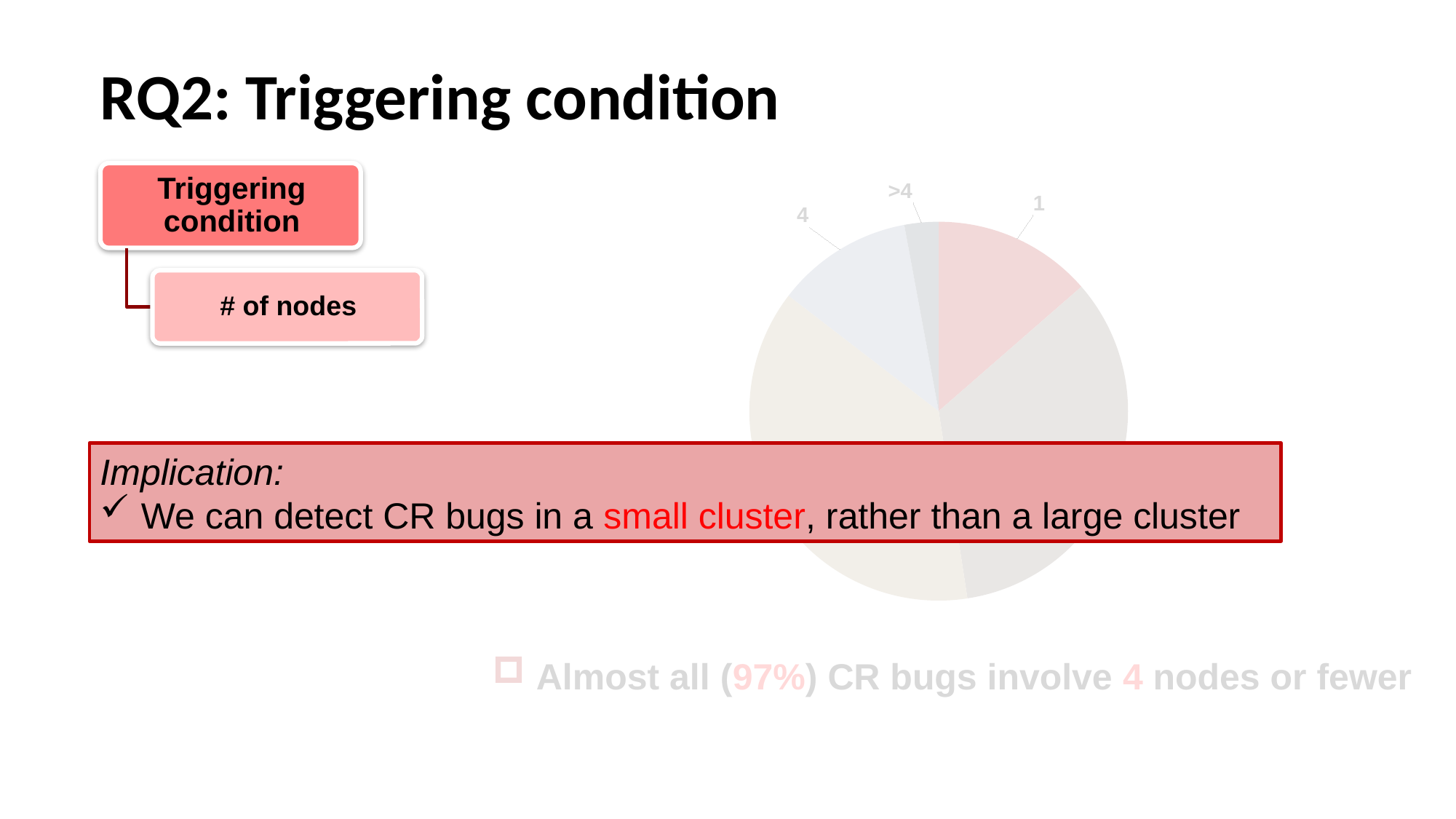
What kind of chart is shown on the slide? pie chart Which slice label in the pie chart indicates more than four nodes? >4 In the pie chart, which slice is larger: the one labelled "4" or the one labelled ">4"? 4 How many slices does the pie chart have? 5 Which labelled slice of the pie chart is the smallest? >4 In the pie chart, which slice is larger: the one labelled "1" or the one labelled ">4"? 1